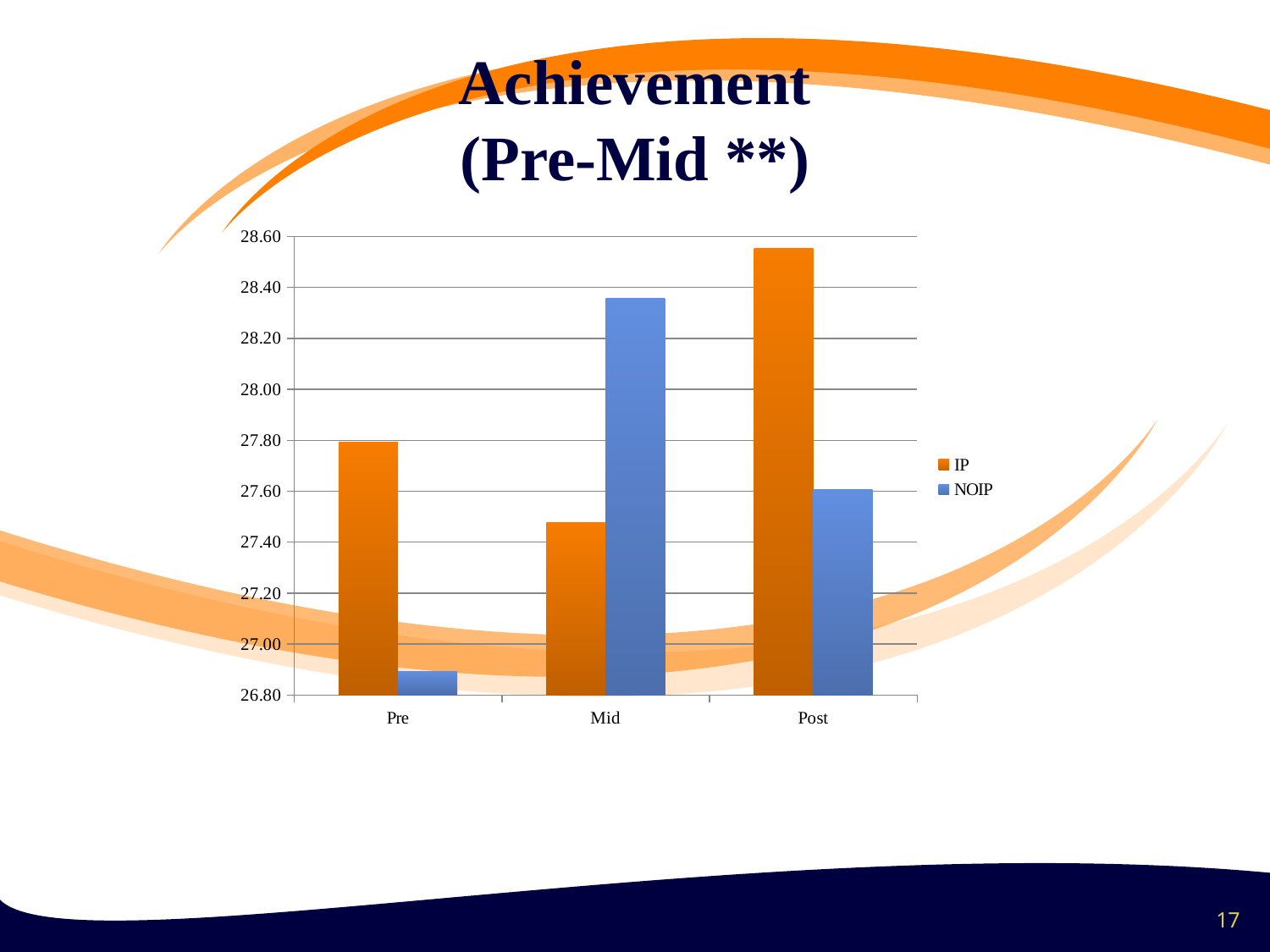
Which category has the lowest NOIP value? Pre Is the NOIP value for Pre greater or less than 27.00? less At Mid, which series has the larger value, IP or NOIP? NOIP Which series is shown in orange? IP Which category has the highest NOIP value? Mid How many categories are shown on the x axis? 3 Is the IP value for Post greater or less than 28.40? greater Is the NOIP value for Mid greater or less than 28.20? greater Which category has the highest IP value? Post How many series does the legend list? 2 What kind of chart is shown on the slide? bar chart Which category has the lowest IP value? Mid